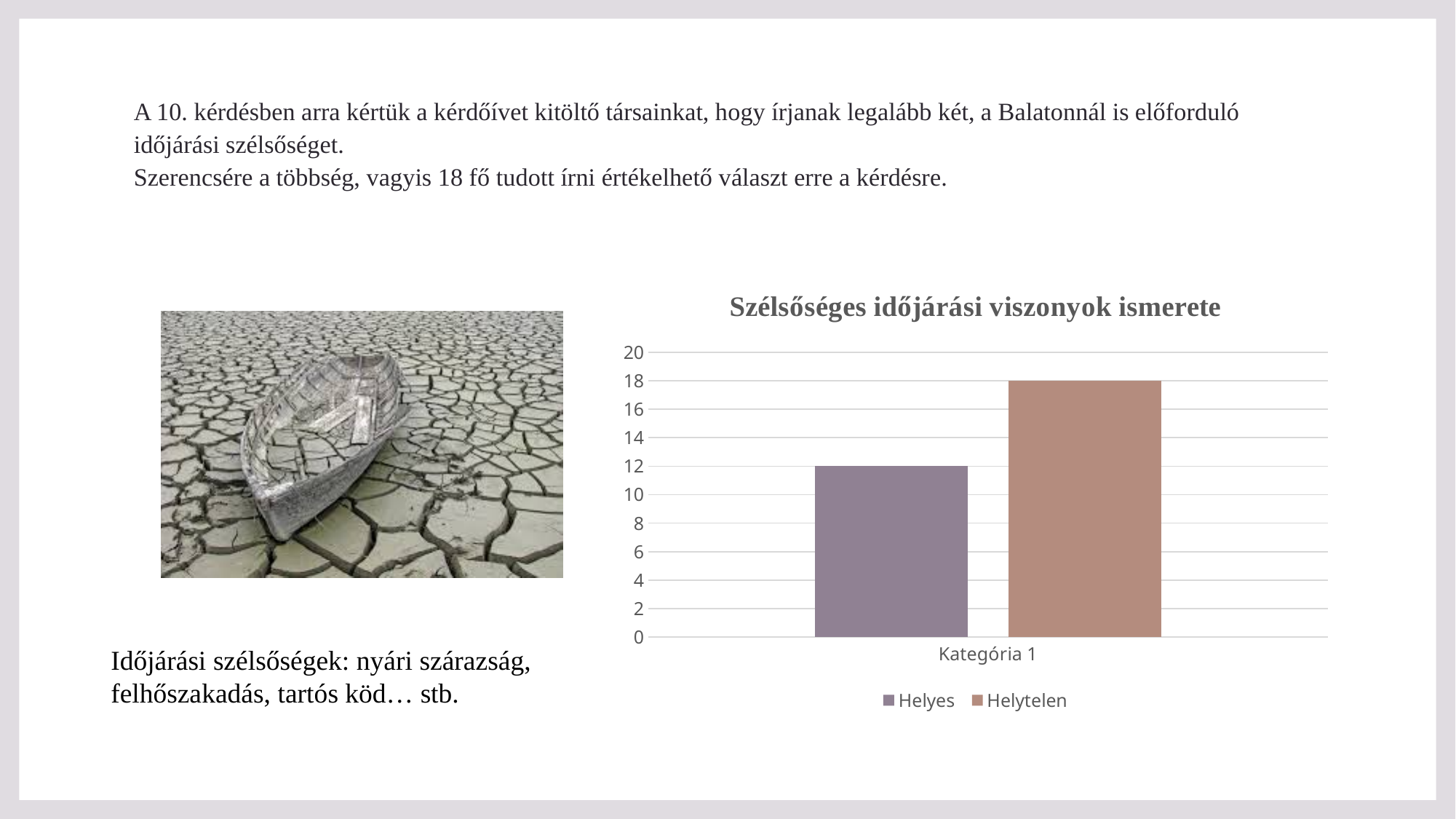
Is the value for Helyes greater or less than 10? greater What is the value of the Helyes series for Kategória 1? 12 What kind of chart is shown on the slide? Bar chart Is the value for Helytelen greater or less than 20? less What is the title of the chart? Szélsőséges időjárási viszonyok ismerete What is the value of the Helytelen series for Kategória 1? 18 Which series has the highest value in the chart? Helytelen Which series has the lowest value in the chart? Helyes How many series does the legend list? 2 Which series has the higher value for Kategória 1, Helyes or Helytelen? Helytelen How many categories are shown on the x axis? 1 What is the difference between the Helytelen and Helyes values for Kategória 1? 6